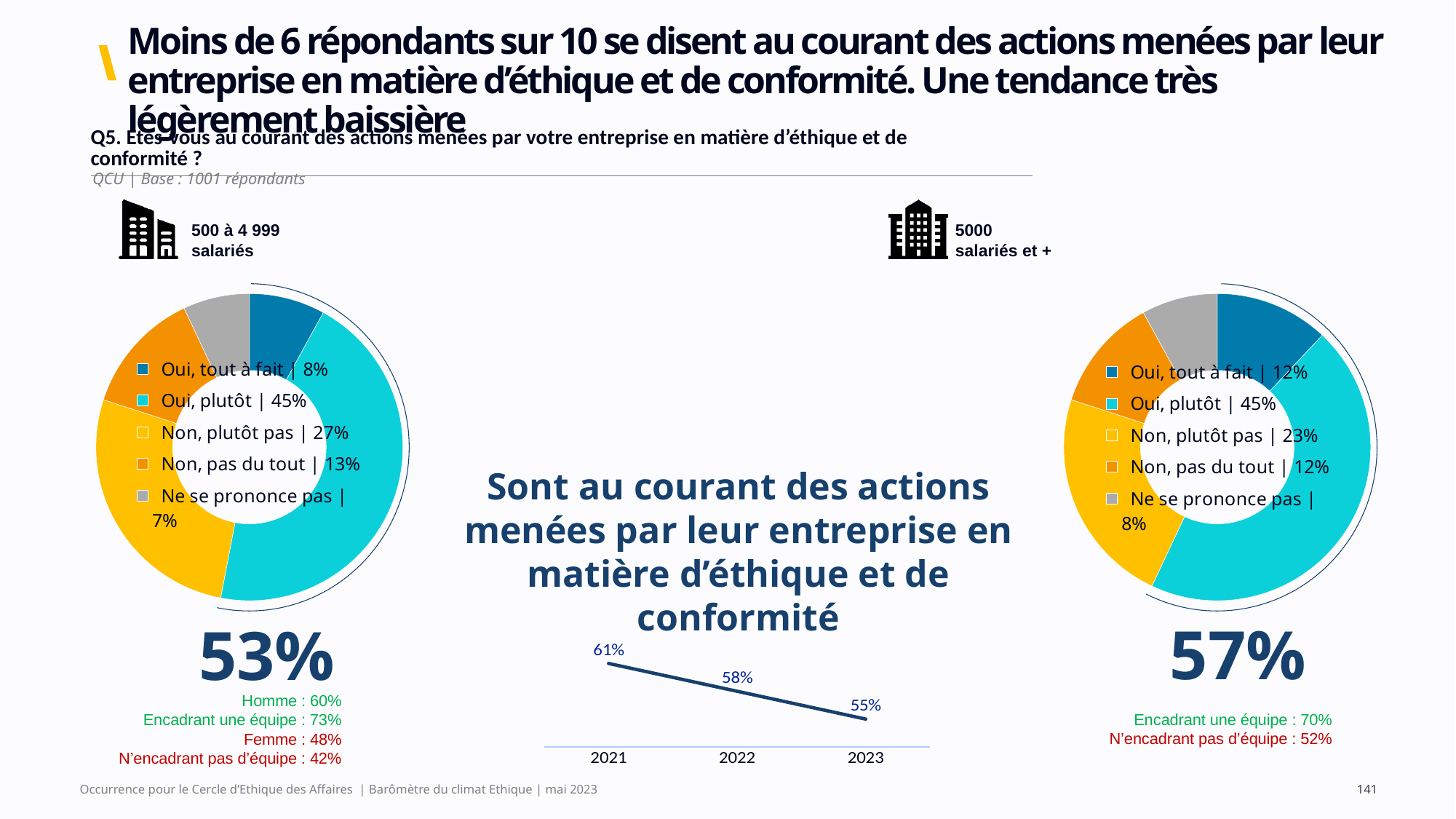
In the left donut chart (500 à 4 999 salariés), which category has the smallest share? Ne se prononce pas In the right donut chart (5000 salariés et +), which category has the smallest share? Ne se prononce pas In the right donut chart (5000 salariés et +), what is the value for "Non, plutôt pas"? 23% In the left donut chart (500 à 4 999 salariés), what is the value for "Non, pas du tout"? 13% In the left donut chart (500 à 4 999 salariés), what is the difference between "Non, plutôt pas" and "Non, pas du tout"? 14 percentage points In the left donut chart (500 à 4 999 salariés), what is the value for "Oui, plutôt"? 45% How many categories does the legend of the left donut chart (500 à 4 999 salariés) list? 5 In the right donut chart (5000 salariés et +), what is the value for "Oui, tout à fait"? 12% In the left donut chart (500 à 4 999 salariés), which category has the largest share? Oui, plutôt In the right donut chart (5000 salariés et +), which is larger: "Oui, tout à fait" or "Non, plutôt pas"? Non, plutôt pas In the center line chart, do the values rise or fall from 2021 to 2023? fall In the center line chart, what is the value for 2021? 61%